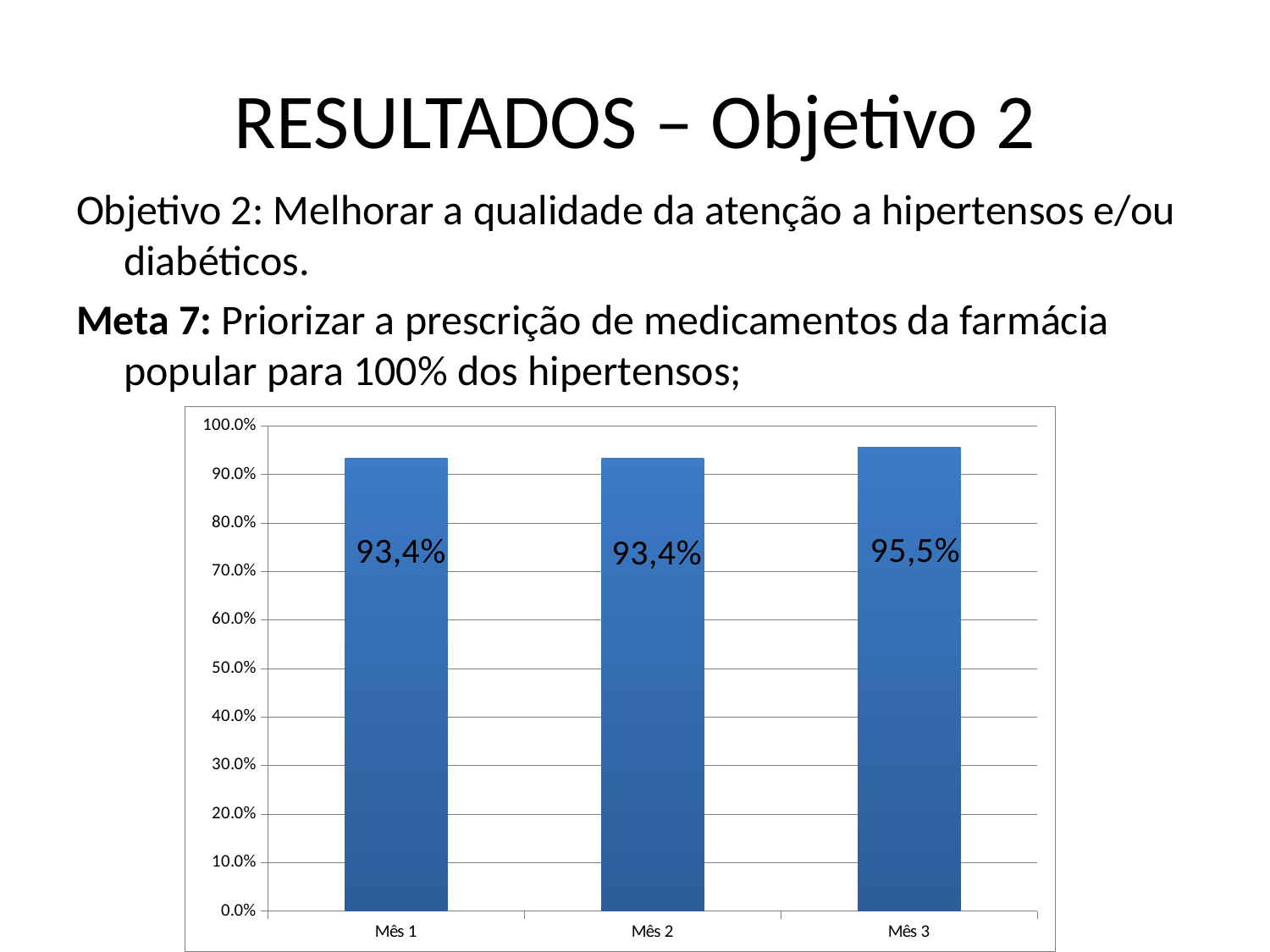
Is the value for Mês 2 greater or less than 90.0%? greater Does any month reach the 100% target stated in Meta 7? No Is the value for Mês 3 larger than the value for Mês 1? Yes What is the value for Mês 3? 95,5% Which month has the highest value? Mês 3 Do the values for Mês 1 and Mês 2 differ? No, both are 93,4% What is the maximum value shown on the y axis? 100.0% What kind of chart is shown on the slide? Bar chart How many months are shown on the x axis? 3 What colour are the bars in the chart? Blue What is the value for Mês 1? 93,4% What is the difference between the values for Mês 3 and Mês 2? 2,1%